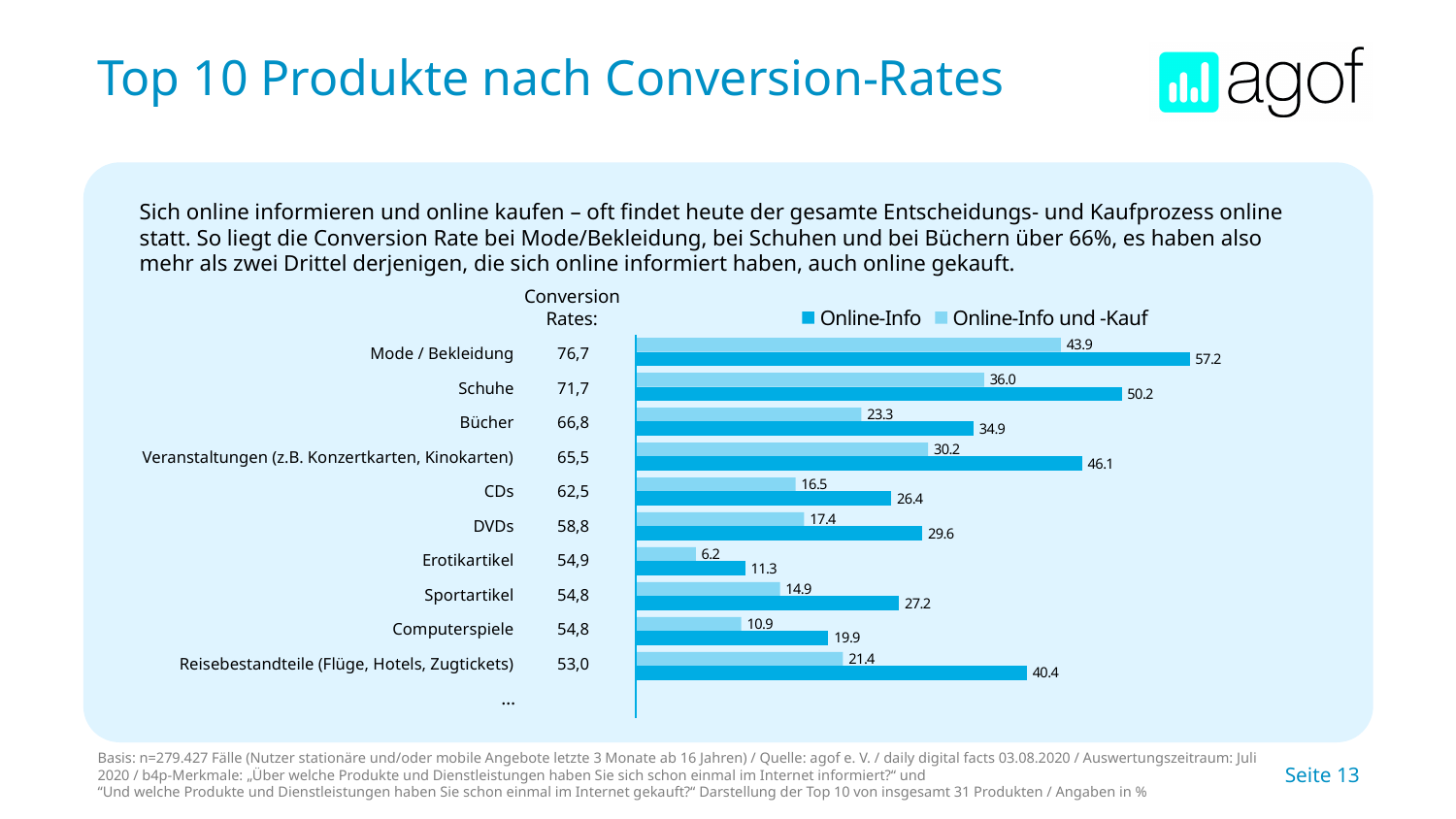
Which category has the highest Online-Info value? Mode / Bekleidung How many series does the legend list? 2 What is the Online-Info value for Mode / Bekleidung? 57.2 Which has the larger Online-Info und -Kauf value, Veranstaltungen (z.B. Konzertkarten, Kinokarten) or Bücher? Veranstaltungen (z.B. Konzertkarten, Kinokarten) What kind of chart is shown on the slide? Bar chart What is the Online-Info und -Kauf value for Schuhe? 36.0 Which has the larger Online-Info value, DVDs or CDs? DVDs What is the Online-Info value for Reisebestandteile (Flüge, Hotels, Zugtickets)? 40.4 What is the difference between the Online-Info and Online-Info und -Kauf values for Mode / Bekleidung? 13.3 What is the difference between the Online-Info and Online-Info und -Kauf values for Schuhe? 14.2 Which category has the lowest Online-Info und -Kauf value? Erotikartikel How many product categories are shown in the chart? 10